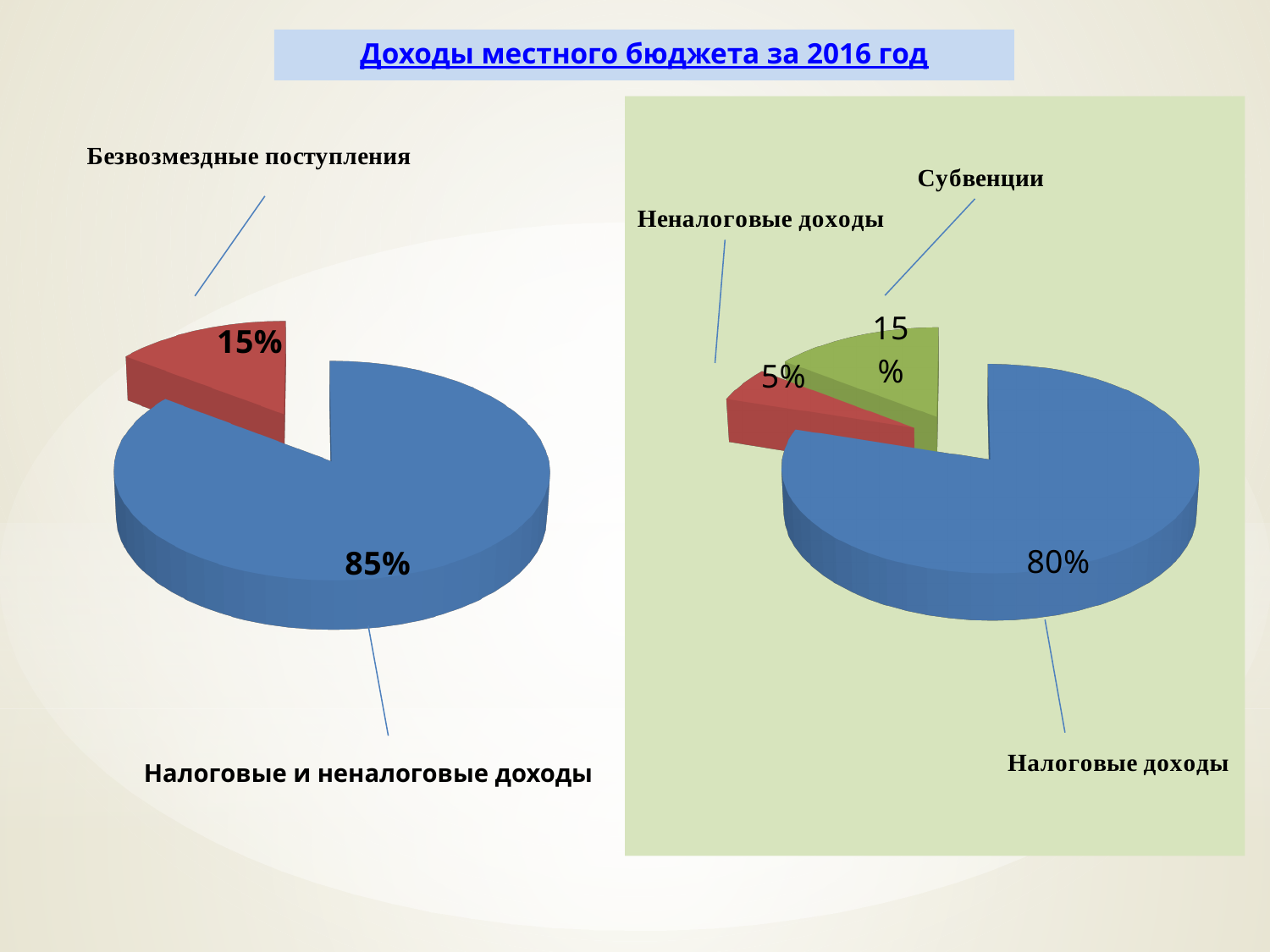
In the right pie chart, what share is labelled for Налоговые доходы? 80% In the right pie chart, what share is labelled for Неналоговые доходы? 5% In the left pie chart, what share is labelled for Безвозмездные поступления? 15% What type of chart is the left chart on the slide? Pie chart In the right pie chart, which is larger: the share of Субвенции or the share of Неналоговые доходы? Субвенции In the left pie chart, what is the difference between the shares of Налоговые и неналоговые доходы and Безвозмездные поступления? 70% In the left pie chart, which category has the largest slice? Налоговые и неналоговые доходы In the right pie chart, what share is labelled for Субвенции? 15% In the right pie chart, which category has the smallest slice? Неналоговые доходы In the left pie chart, what share is labelled for Налоговые и неналоговые доходы? 85% In the right pie chart, which category has the largest slice? Налоговые доходы How many slices does the right pie chart have? 3